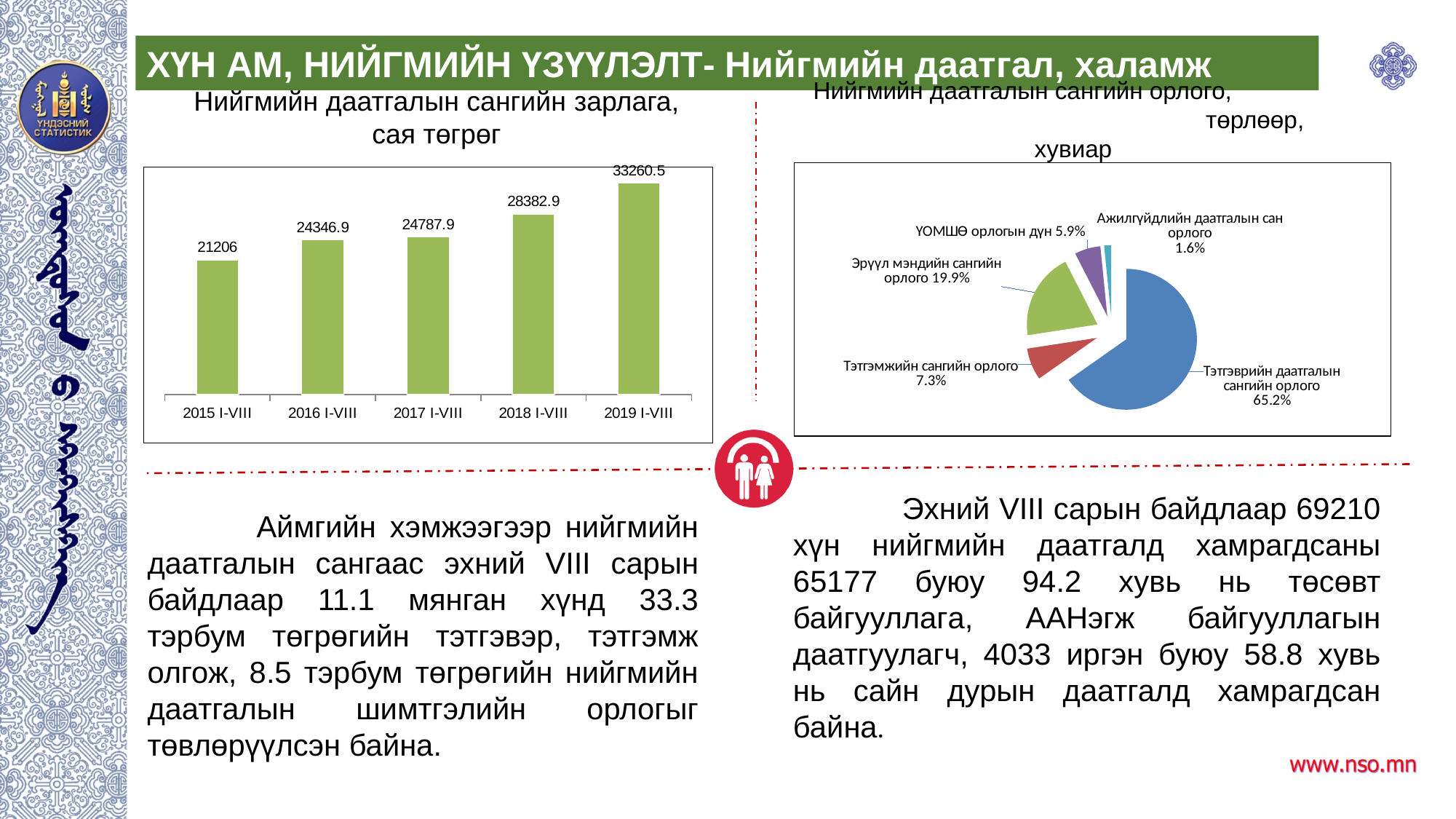
In the pie chart on the right, which category has the smallest share? Ажилгүйдлийн даатгалын сан орлого In the pie chart on the right, what share does Эрүүл мэндийн сангийн орлого have? 19.9% What type of chart is shown on the left side of the slide? bar chart In the pie chart on the right, which is larger: Тэтгэмжийн сангийн орлого or ҮОМШӨ орлогын дүн? Тэтгэмжийн сангийн орлого In the pie chart on the right (Нийгмийн даатгалын сангийн орлого), what share does Тэтгэврийн даатгалын сангийн орлого have? 65.2% In the bar chart on the left, do the values rise or fall from 2015 I-VIII to 2019 I-VIII? rise In the bar chart on the left, which period has the highest value? 2019 I-VIII In the bar chart on the left, what is the value for 2015 I-VIII? 21206 In the bar chart on the left, which period has the lowest value? 2015 I-VIII In the bar chart on the left (Нийгмийн даатгалын сангийн зарлага), what is the value for 2019 I-VIII? 33260.5 In the bar chart on the left, what is the difference between the values for 2019 I-VIII and 2018 I-VIII? 4877.6 How many bars are shown in the bar chart on the left? 5